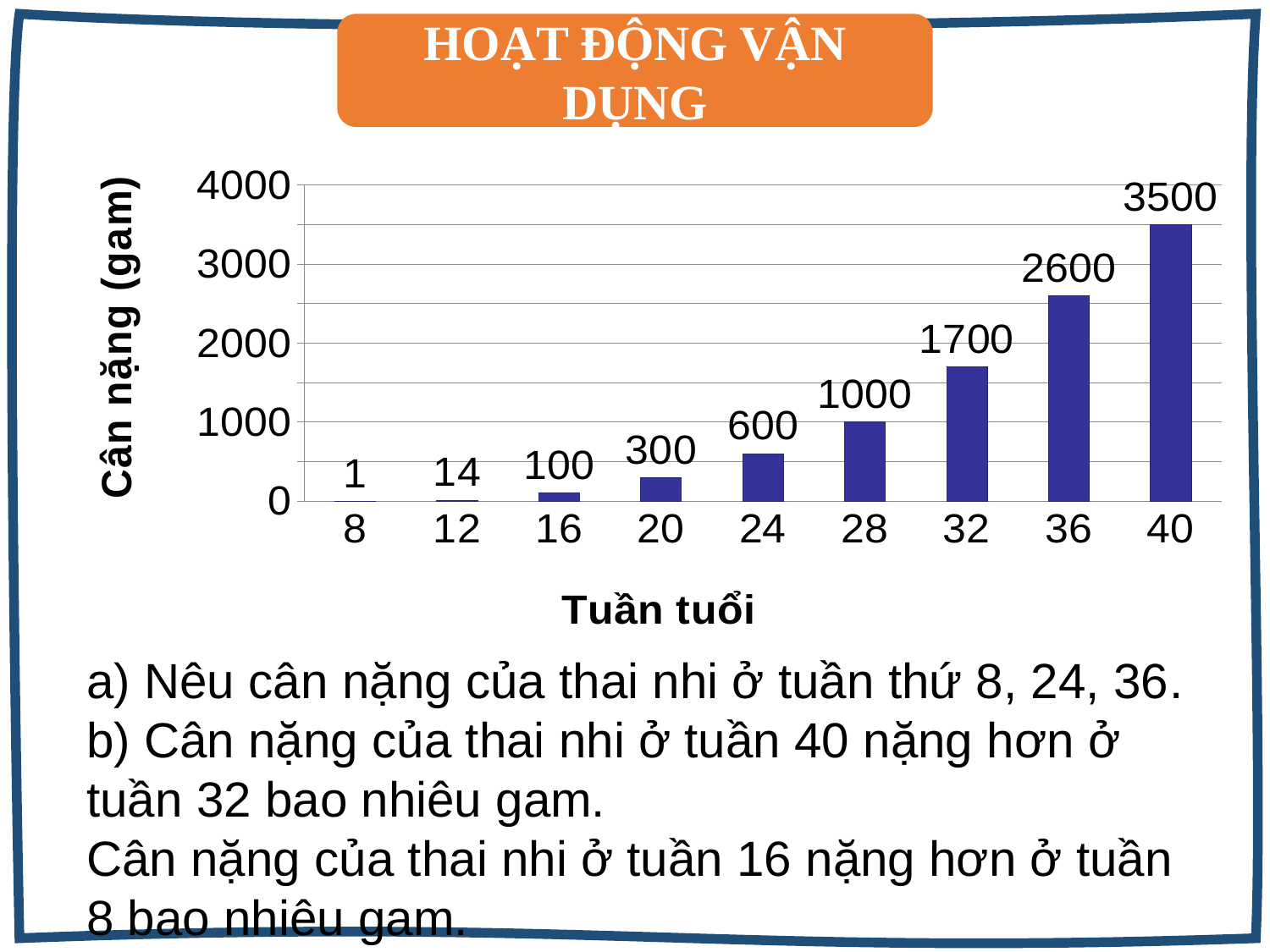
Which is larger, the weight at week 28 or at week 20? week 28 What kind of chart is shown on the slide? bar chart What is the weight (cân nặng) at week 36? 2600 What is the weight (cân nặng) at week 8? 1 How many weeks (categories) are shown on the x axis? 9 How much heavier is the weight at week 16 than at week 8? 99 Which week (tuần tuổi) has the lowest weight? 8 What is the weight (cân nặng) at week 24? 600 Do the weights rise or fall as the week number increases? rise How much heavier is the weight at week 40 than at week 32? 1800 What is the label of the y axis? Cân nặng (gam) Which week (tuần tuổi) has the highest weight? 40